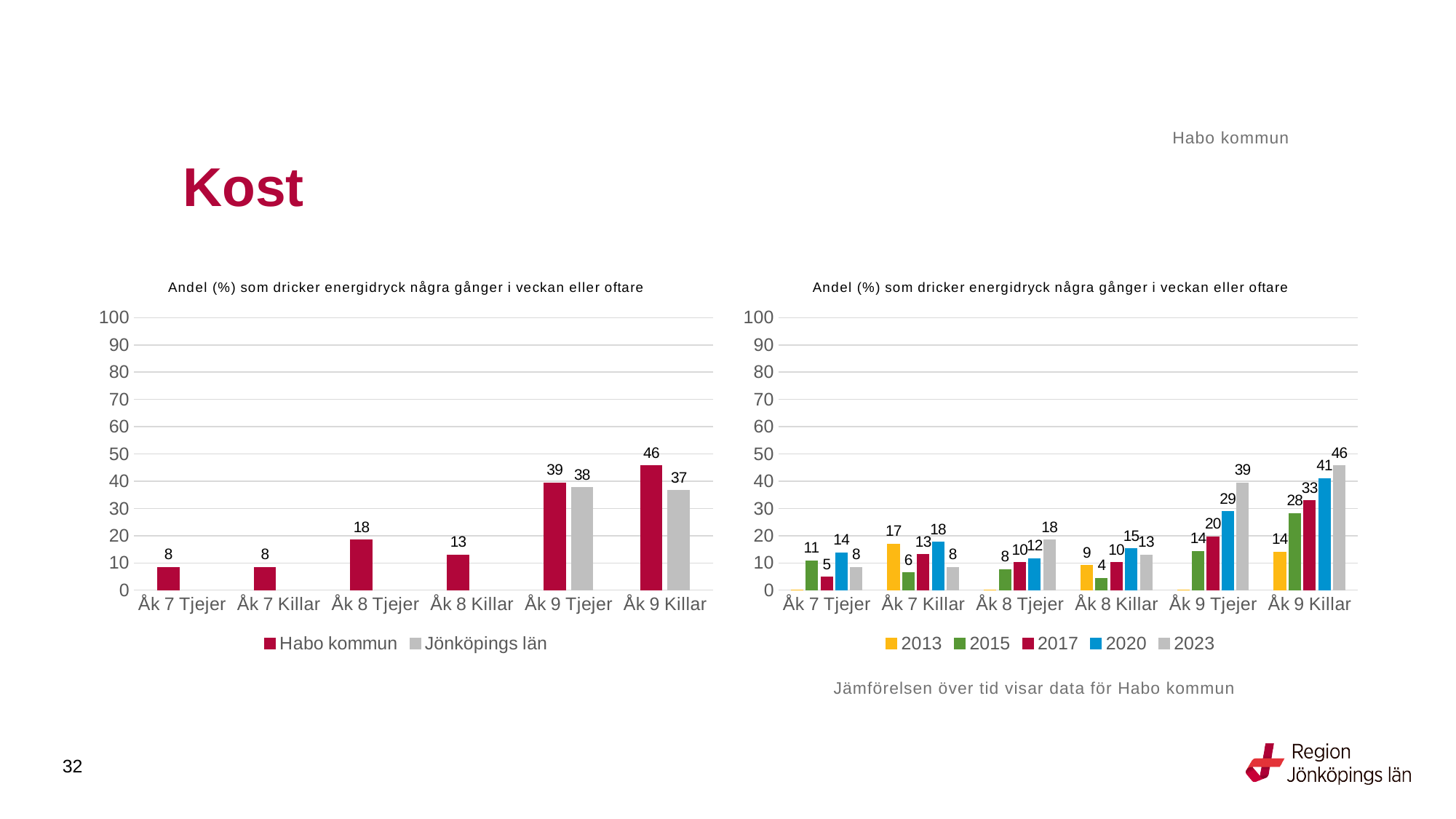
In the left chart, what is the value for Habo kommun for Åk 9 Killar? 46 In the right chart, how many series does the legend list? 5 In the left chart, what is the difference between Habo kommun and Jönköpings län for Åk 9 Killar? 9 In the right chart, what is the difference between the 2023 and 2017 values for Åk 9 Tjejer? 19 In the right chart, which is larger for Åk 8 Tjejer: 2015 or 2023? 2023 What kind of chart is the left chart? Bar chart In the left chart, which category has the highest value for Habo kommun? Åk 9 Killar In the right chart, what is the value for 2020 for Åk 9 Tjejer? 29 In the right chart, what is the value for 2013 for Åk 7 Killar? 17 In the left chart, what is the value for Jönköpings län for Åk 9 Tjejer? 38 In the left chart, how many series does the legend list? 2 In the right chart, which year has the highest value for Åk 9 Killar? 2023